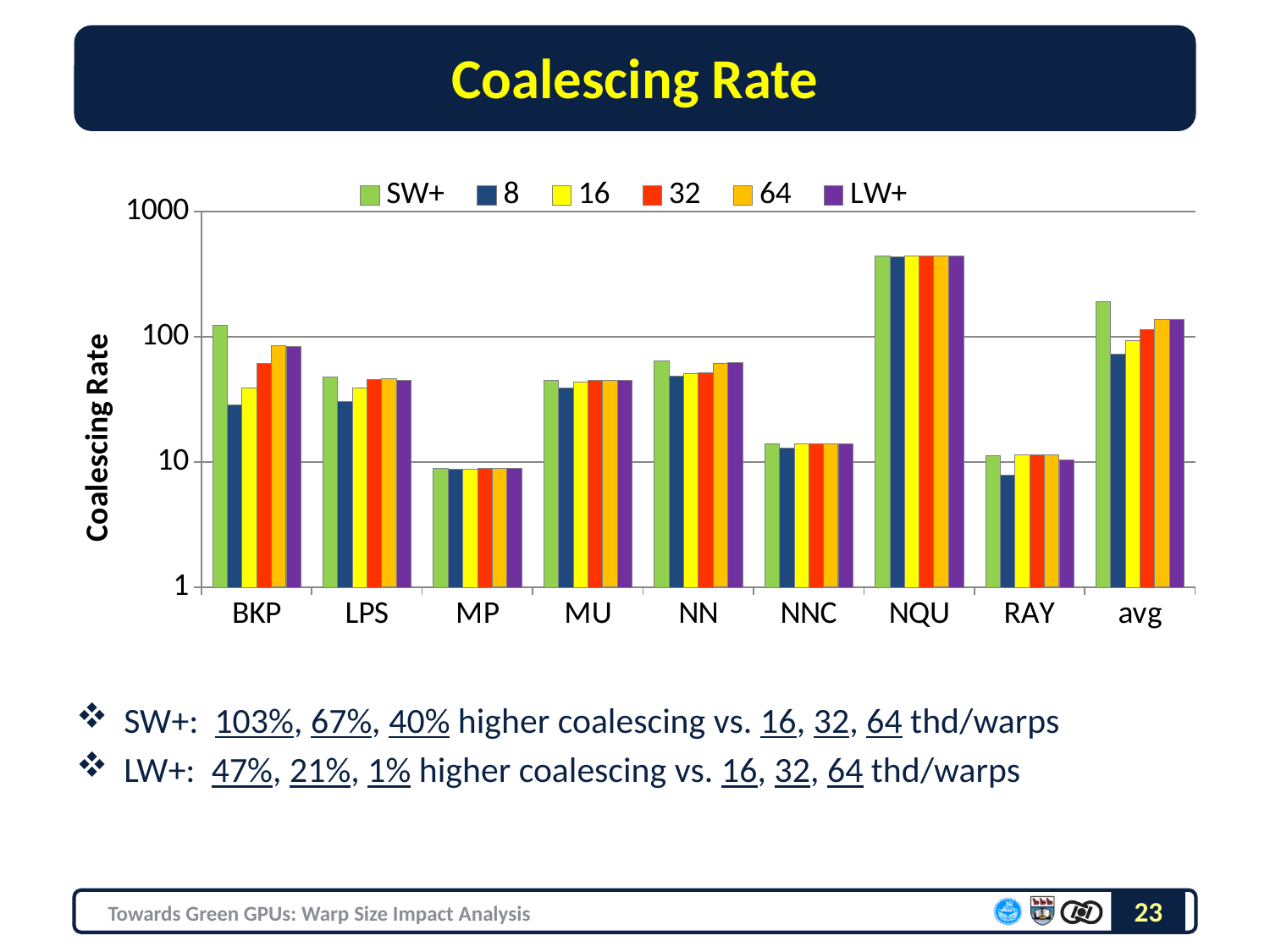
Is the SW+ value for MP greater or less than 10? less For avg, which is larger: the SW+ value or the LW+ value? SW+ Which category has the lowest value for the SW+ series? MP For BKP, which is larger: the SW+ value or the 8 value? SW+ What is the label on the chart's vertical axis? Coalescing Rate Is the LW+ value for NQU greater or less than 100? greater How many series does the chart's legend list? 6 Which category has the highest value for the SW+ series? NQU What kind of chart is shown on the slide? bar chart Is the SW+ value for BKP greater or less than 100? greater How many categories are shown along the x axis of the chart? 9